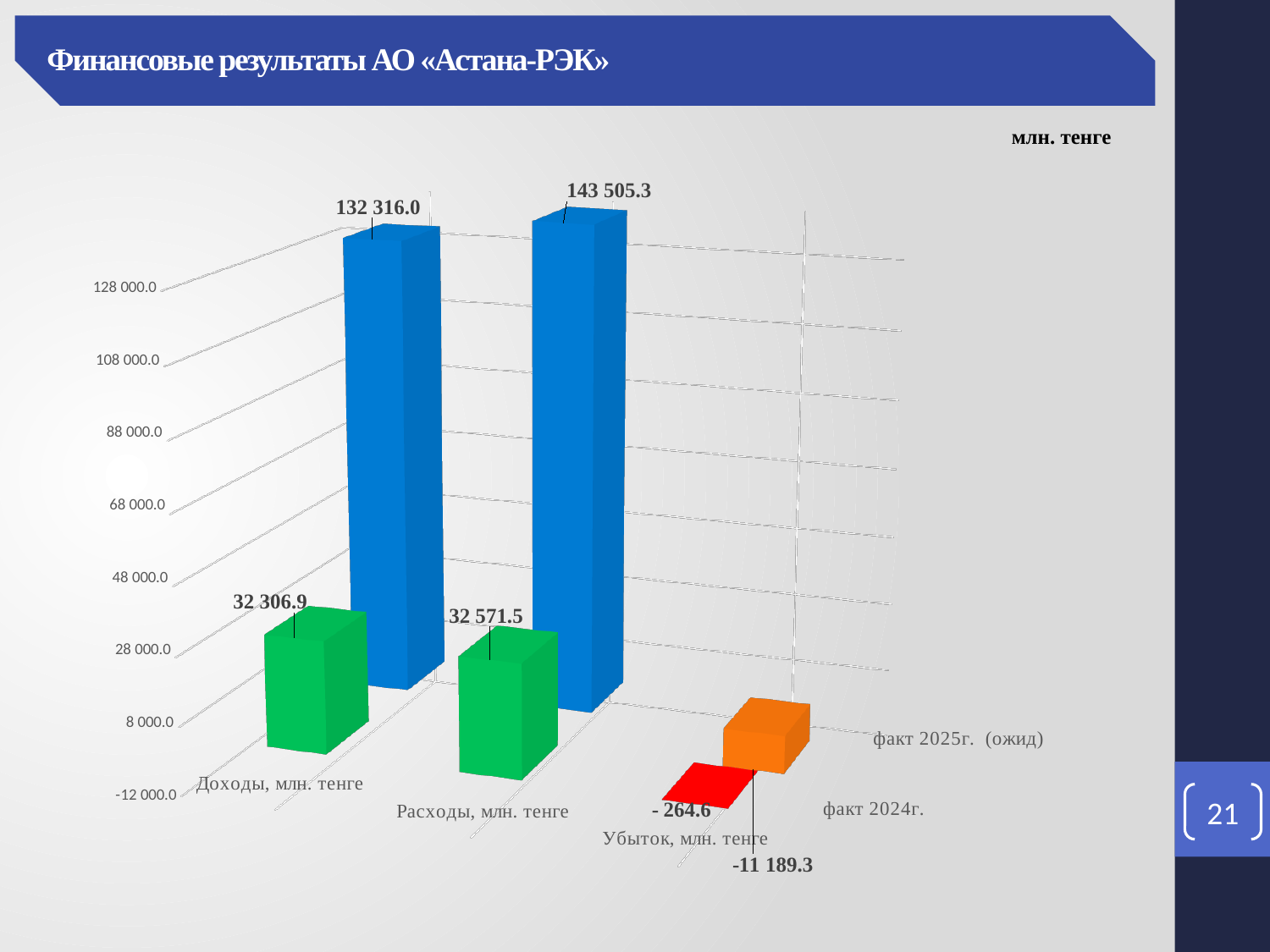
How many categories are shown on the x axis? 3 What unit is indicated in the top right corner of the chart? млн. тенге What is the value of Доходы for факт 2025г. (ожид)? 132 316.0 What is the value of Убыток for факт 2025г. (ожид)? -11 189.3 What is the difference between Расходы and Доходы for факт 2025г. (ожид)? 11 189.3 Which category has the highest value for факт 2025г. (ожид)? Расходы, млн. тенге What is the value of Доходы for факт 2024г.? 32 306.9 How many series does the chart show? 2 Which is larger: Расходы for факт 2025г. (ожид) or Расходы for факт 2024г.? факт 2025г. (ожид) What is the value of Убыток for факт 2024г.? - 264.6 What type of chart is shown on the slide? bar chart What is the value of Расходы for факт 2024г.? 32 571.5